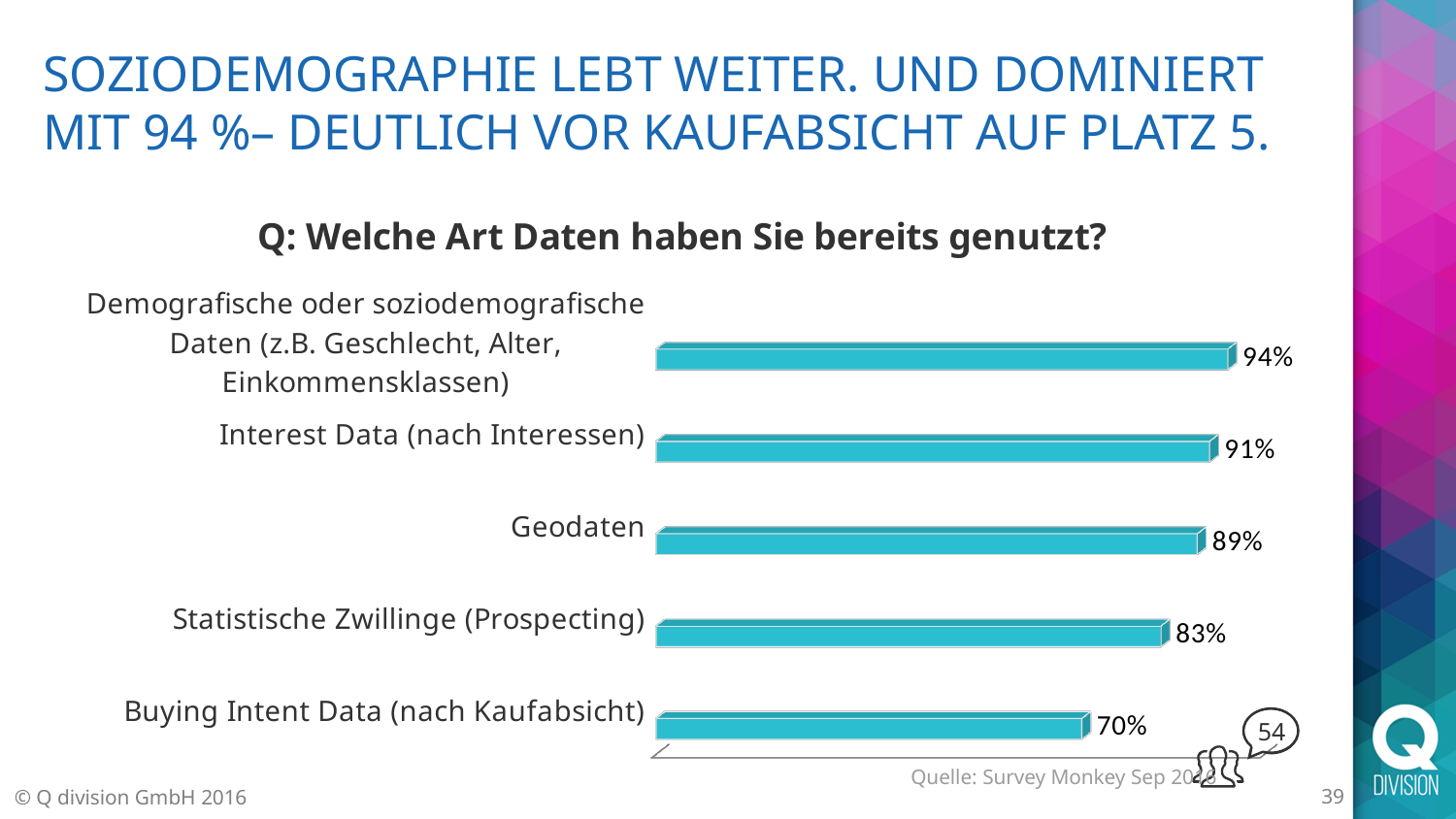
What is the value for Buying Intent Data (nach Kaufabsicht)? 70% Which category has the highest value? Demografische oder soziodemografische Daten (z.B. Geschlecht, Alter, Einkommensklassen) Which is larger, the value for Geodaten or the value for Statistische Zwillinge (Prospecting)? Geodaten What is the value for Interest Data (nach Interessen)? 91% What kind of chart is shown on the slide? bar chart How many categories are shown in the chart? 5 What is the difference between the values for Demografische oder soziodemografische Daten and Buying Intent Data? 24% What is the value for Geodaten? 89% What is the difference between the values for Geodaten and Statistische Zwillinge (Prospecting)? 6% What question is the chart titled with? Q: Welche Art Daten haben Sie bereits genutzt? What is the value for Statistische Zwillinge (Prospecting)? 83% Which category has the lowest value? Buying Intent Data (nach Kaufabsicht)